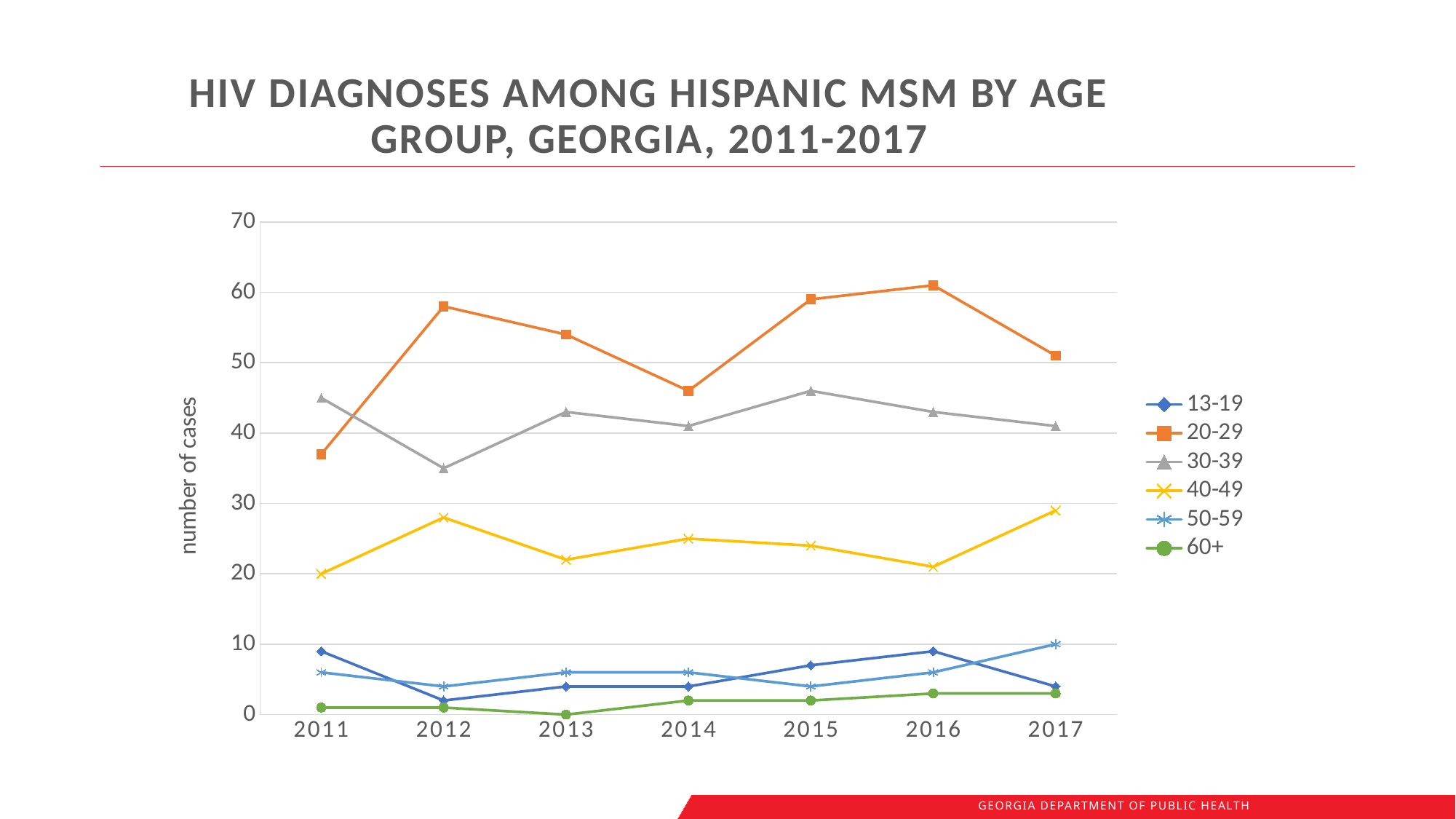
Is the value for the 20-29 age group in 2012 greater or less than 50? greater In 2011, which age group has more cases: 20-29 or 30-39? 30-39 What is the label on the y axis? number of cases Which age group has the highest number of cases in every year from 2012 to 2017? 20-29 In which year is the number of cases for the 30-39 age group lowest? 2012 In 2017, which age group has more cases: 13-19 or 50-59? 50-59 Is the value for the 30-39 age group in 2012 greater or less than 40? less How many age-group series does the legend list? 6 How many years are plotted along the x axis? 7 In which year is the number of cases for the 20-29 age group lowest? 2011 In which year is the number of cases for the 60+ age group lowest? 2013 What kind of chart is shown on the slide? line chart